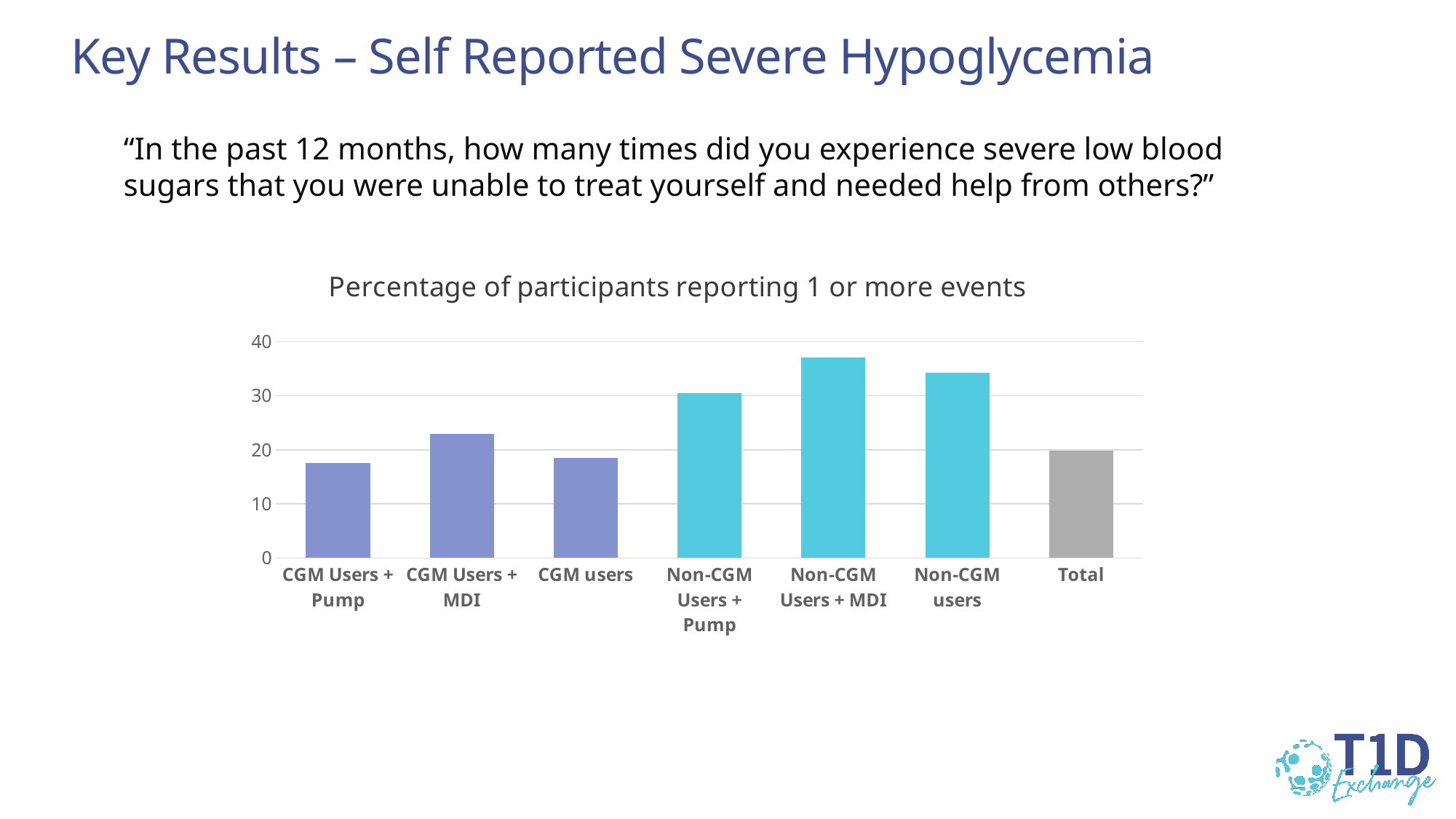
Is the value for Non-CGM Users + MDI greater or less than 40? less What is the title of the chart? Percentage of participants reporting 1 or more events Is the value for CGM Users + Pump greater or less than 20? less Is the value for CGM users greater or less than 20? less Which category has the highest value? Non-CGM Users + MDI What kind of chart is shown on the slide? bar chart What colour is the Total bar? gray How many bars are plotted in the chart? 7 Which is larger, the value for Non-CGM Users + Pump or the value for CGM Users + Pump? Non-CGM Users + Pump Which is larger, the value for CGM users or the value for Non-CGM users? Non-CGM users